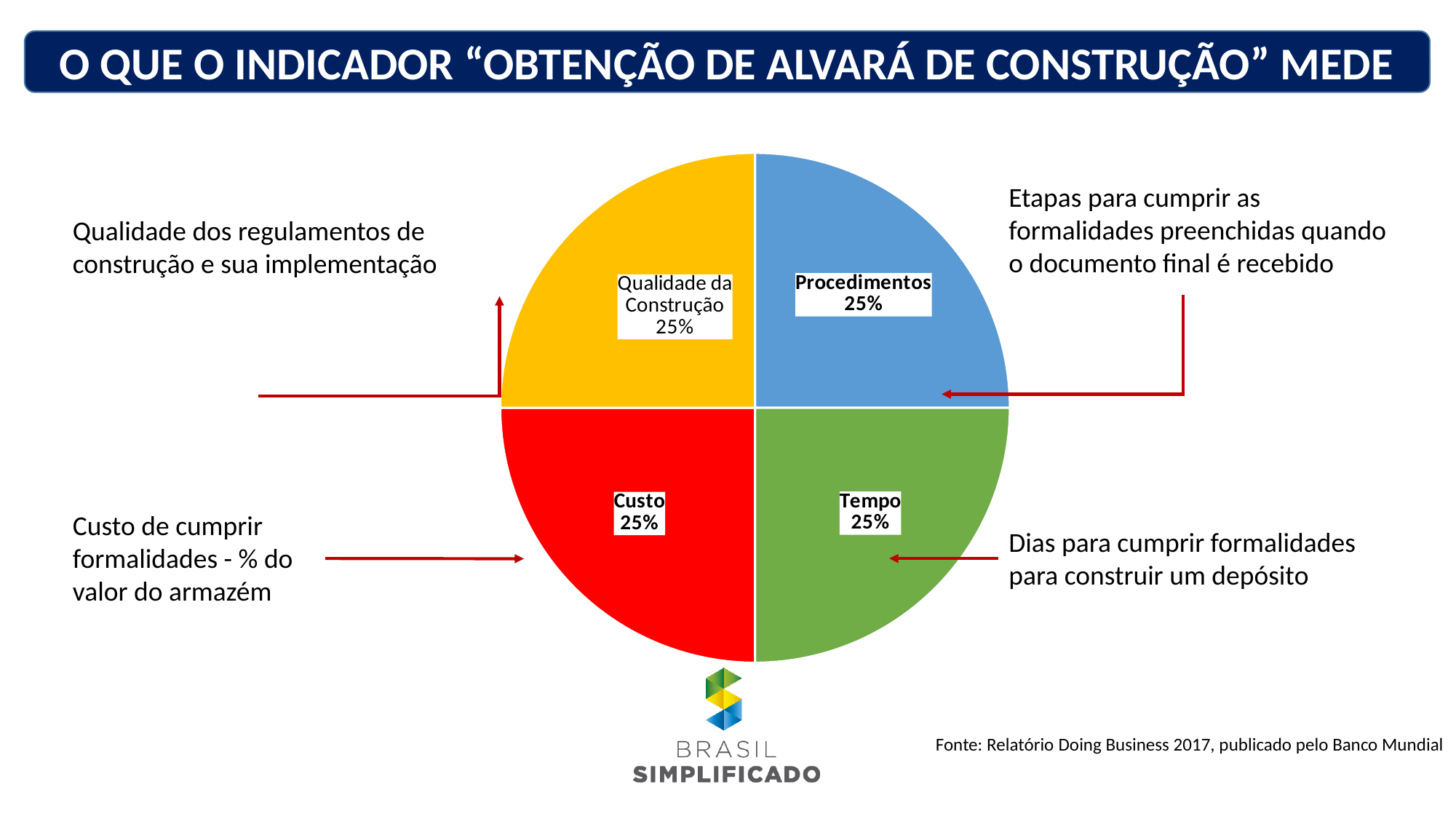
What percentage is shown for the Qualidade da Construção slice? 25% What kind of chart is shown on the slide? Pie chart What percentage is shown for the Tempo slice? 25% What colour is the Custo slice? Red What percentage is shown for the Procedimentos slice? 25% Is the Procedimentos slice larger than, smaller than, or equal to the Tempo slice? Equal How many slices does the pie chart have? 4 What percentage is shown for the Custo slice? 25% What is the difference between the Custo and Procedimentos slices? 0% What share of the pie does the Tempo slice represent? 25% Which slice is coloured green? Tempo